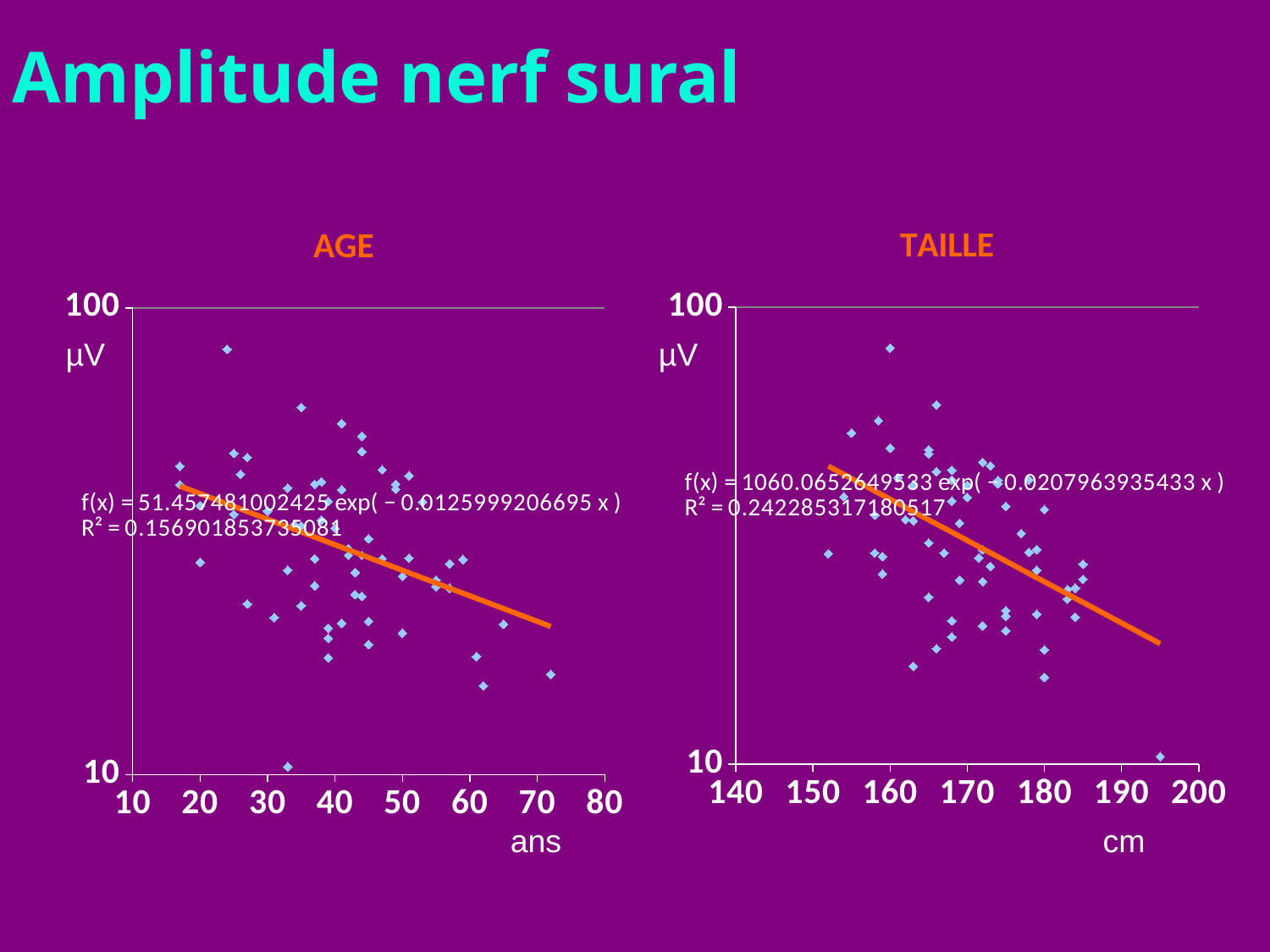
What is the lowest tick value on the x axis of the TAILLE chart? 140 What is the highest tick value on the x axis of the AGE chart? 80 Which chart has the higher R² value, AGE or TAILLE? TAILLE In the AGE chart, does the fitted trend line rise or fall as age increases along the x axis? fall What is the highest tick value on the y axis of the TAILLE chart? 100 In the TAILLE chart, does the fitted trend line rise or fall as height increases along the x axis? fall What is the R² value shown on the AGE chart? 0.156901853735081 What kind of chart is the AGE chart? scatter chart What is the unit shown on the x axis of the TAILLE chart? cm What is the unit shown on the x axis of the AGE chart? ans What is the R² value shown on the TAILLE chart? 0.242285317180517 What kind of chart is the TAILLE chart? scatter chart